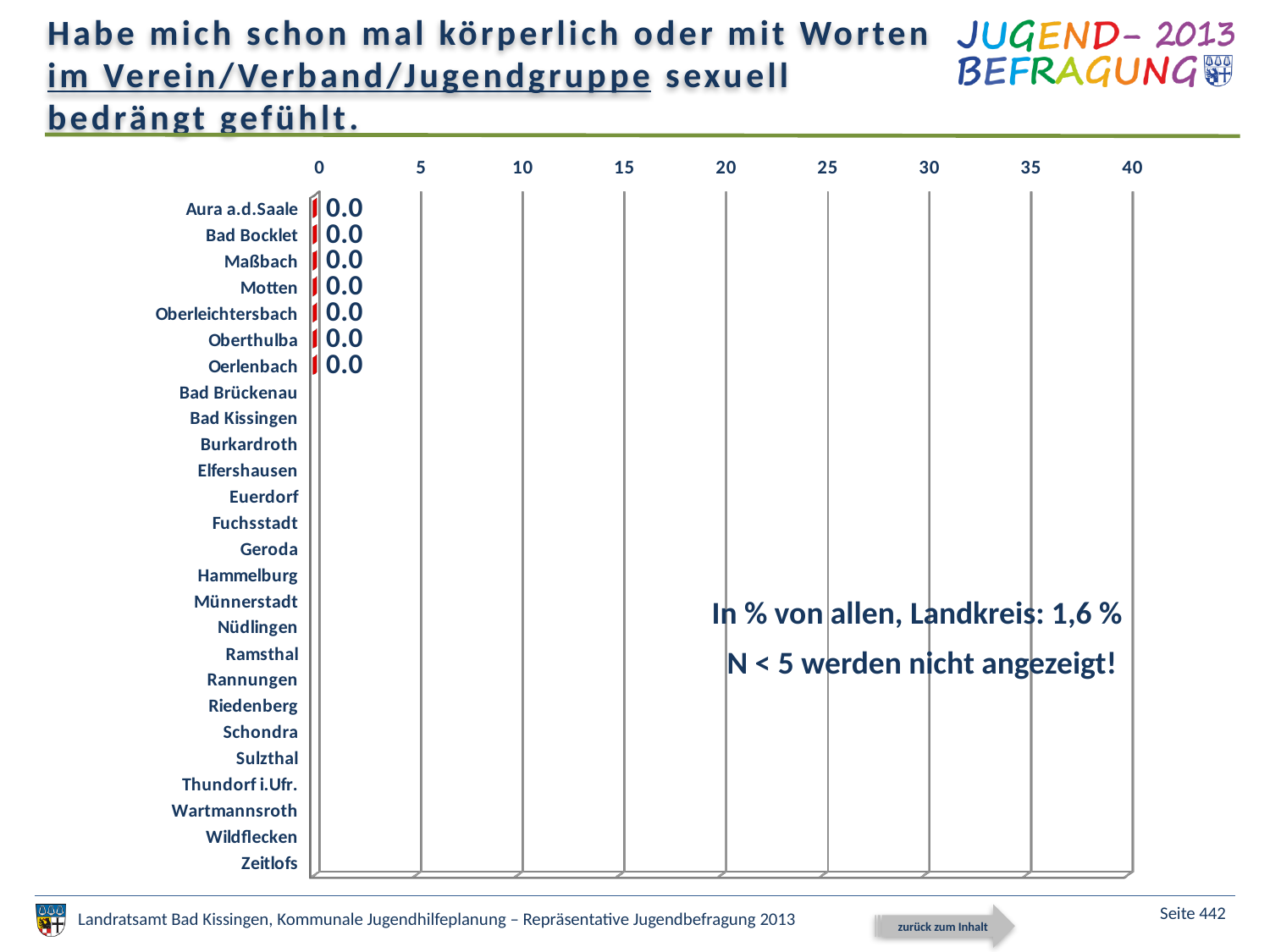
What kind of chart is shown on the slide? bar chart What is the difference between the values for Bad Bocklet and Motten? 0.0 What value is shown for Oerlenbach? 0.0 How many categories have a data label printed on the chart? 7 According to the note on the chart, what is the percentage for the whole Landkreis? 1,6 % What value is shown for Oberthulba? 0.0 What value is shown for Aura a.d.Saale? 0.0 What value is shown for Maßbach? 0.0 Is the value for Oberleichtersbach greater or less than 5? less What is the highest value shown on the horizontal axis of the chart? 40 How many categories (municipalities) are listed on the vertical axis of the chart? 26